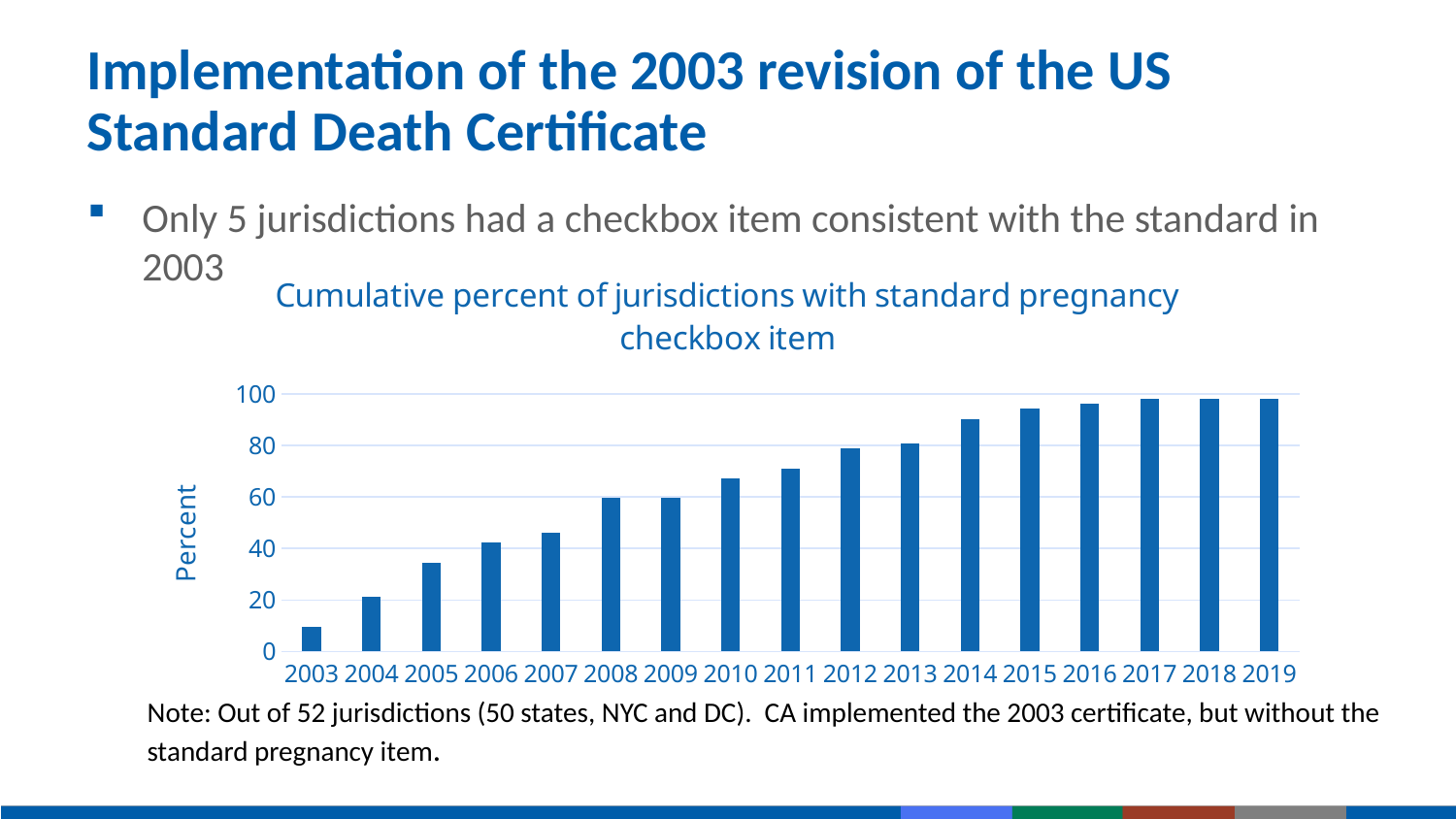
What kind of chart is shown on the slide? bar chart Which year has the lowest cumulative percent of jurisdictions with the standard pregnancy checkbox item? 2003 Which year has the larger value, 2005 or 2010? 2010 What is the label on the y axis of the chart? Percent Is the value for 2014 greater or less than 80? greater How many years are shown on the x axis of the chart? 17 Do the values rise or fall from 2003 to 2019? rise Is the value for 2010 greater or less than 60? greater Is the value for 2007 greater or less than 40? greater